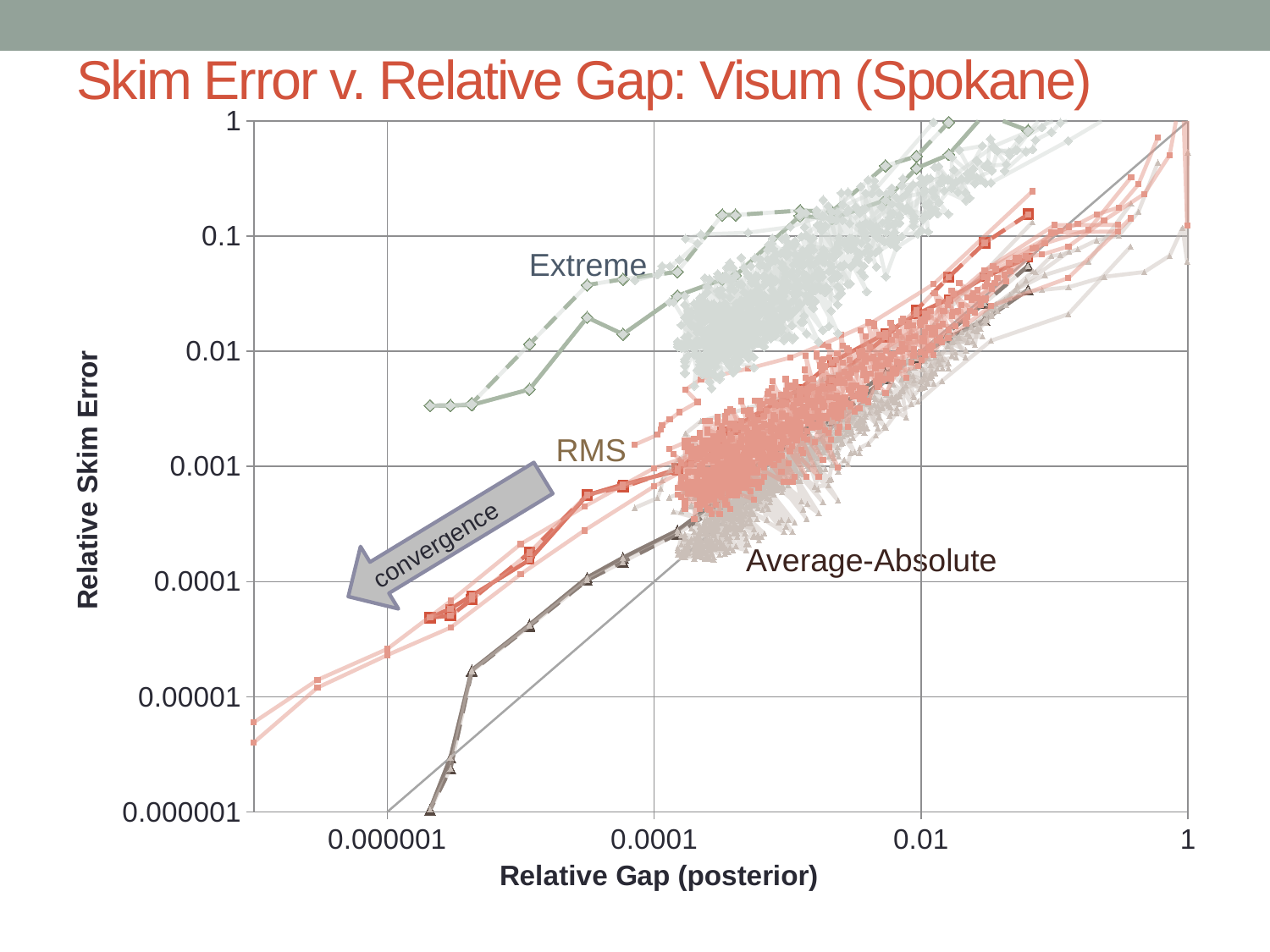
What kind of chart is shown on the slide? scatter chart At a relative gap of 0.0001, is the Average-Absolute relative skim error greater or less than 0.001? less Which labeled series has the highest relative skim error at a given relative gap? Extreme How many labeled series are shown on the chart? 3 At a relative gap of 0.0001, is the Extreme relative skim error greater or less than 0.01? greater What word is written on the arrow pointing toward the lower left of the chart? convergence What is the title of the chart? Skim Error v. Relative Gap: Visum (Spokane) At a relative gap of 0.0001, which series has the larger relative skim error, RMS or Average-Absolute? RMS Which labeled series has the lowest relative skim error at a given relative gap? Average-Absolute What is the lowest tick value shown on the y axis? 0.000001 At a relative gap of 0.0001, which series has the larger relative skim error, Extreme or RMS? Extreme Does the relative skim error rise or fall as the relative gap increases along the x axis? rise